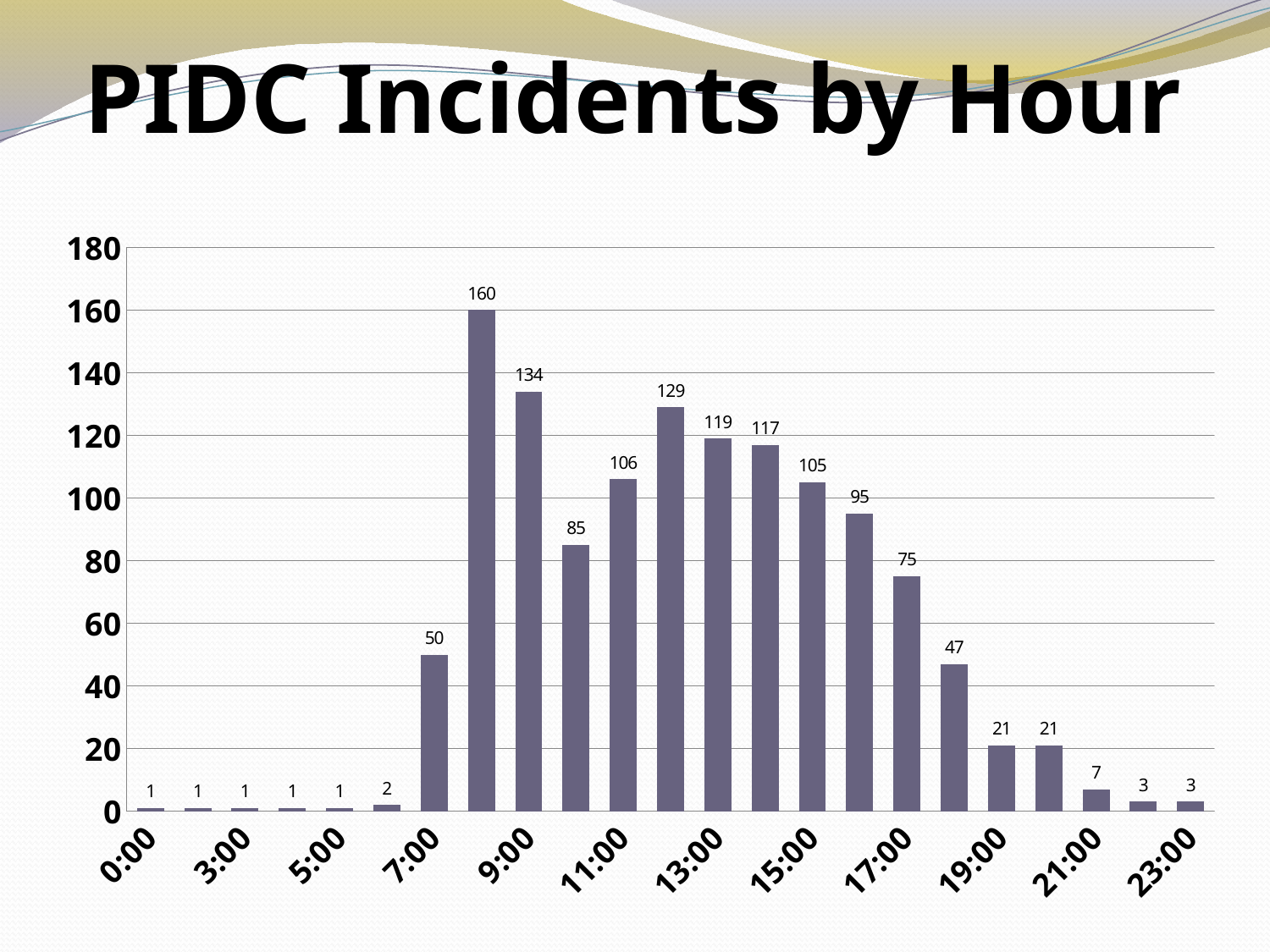
What kind of chart is shown on the slide? bar chart How many incidents are shown for 7:00? 50 What is the title of the chart? PIDC Incidents by Hour How many incidents are shown for 21:00? 7 How many bars are plotted on the chart? 23 What is the difference between the values for 9:00 and 7:00? 84 Is the value for 15:00 greater or less than 100? greater What is the highest value shown on the chart? 160 How many incidents are shown for 9:00? 134 How many incidents are shown for 13:00? 119 How many incidents are shown for 17:00? 75 Which has more incidents, 11:00 or 13:00? 13:00